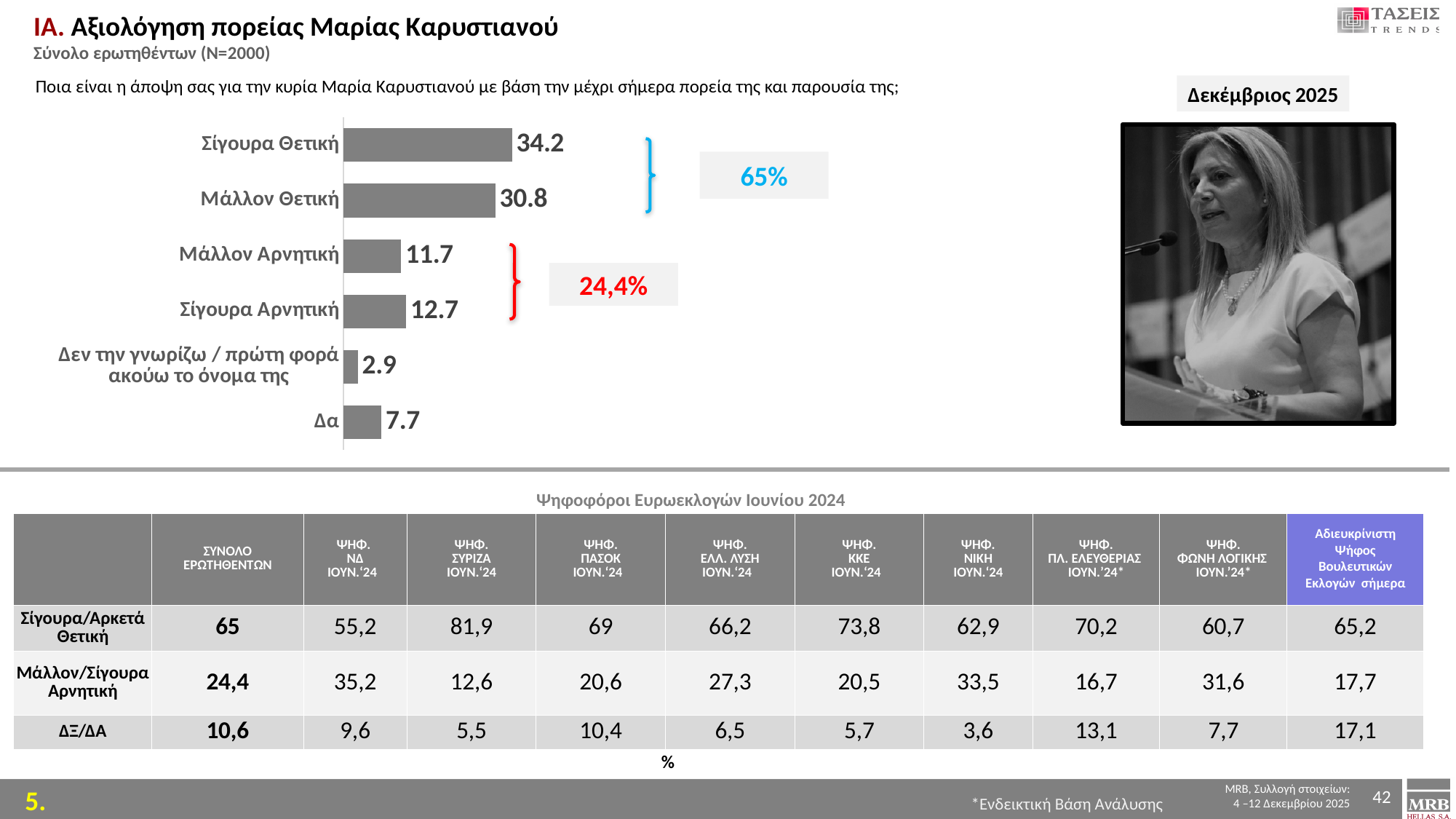
Which category has the highest value in the bar chart? Σίγουρα Θετική What is the value for Δα in the bar chart? 7.7 What is the difference between the values for Δα and Δεν την γνωρίζω / πρώτη φορά ακούω το όνομα της? 4.8 Which is larger, the value for Σίγουρα Αρνητική or the value for Μάλλον Αρνητική? Σίγουρα Αρνητική What percentage is shown in the blue-labelled box grouping the two positive categories? 65% What is the combined value of Μάλλον Αρνητική and Σίγουρα Αρνητική shown in the red-labelled box next to the chart? 24,4% Which category has the lowest value in the bar chart? Δεν την γνωρίζω / πρώτη φορά ακούω το όνομα της How many categories are shown in the bar chart? 6 What is the value for Σίγουρα Θετική in the bar chart? 34.2 What kind of chart is shown on the slide? bar chart What is the value for Μάλλον Αρνητική in the bar chart? 11.7 What is the difference between the values for Σίγουρα Θετική and Μάλλον Θετική? 3.4